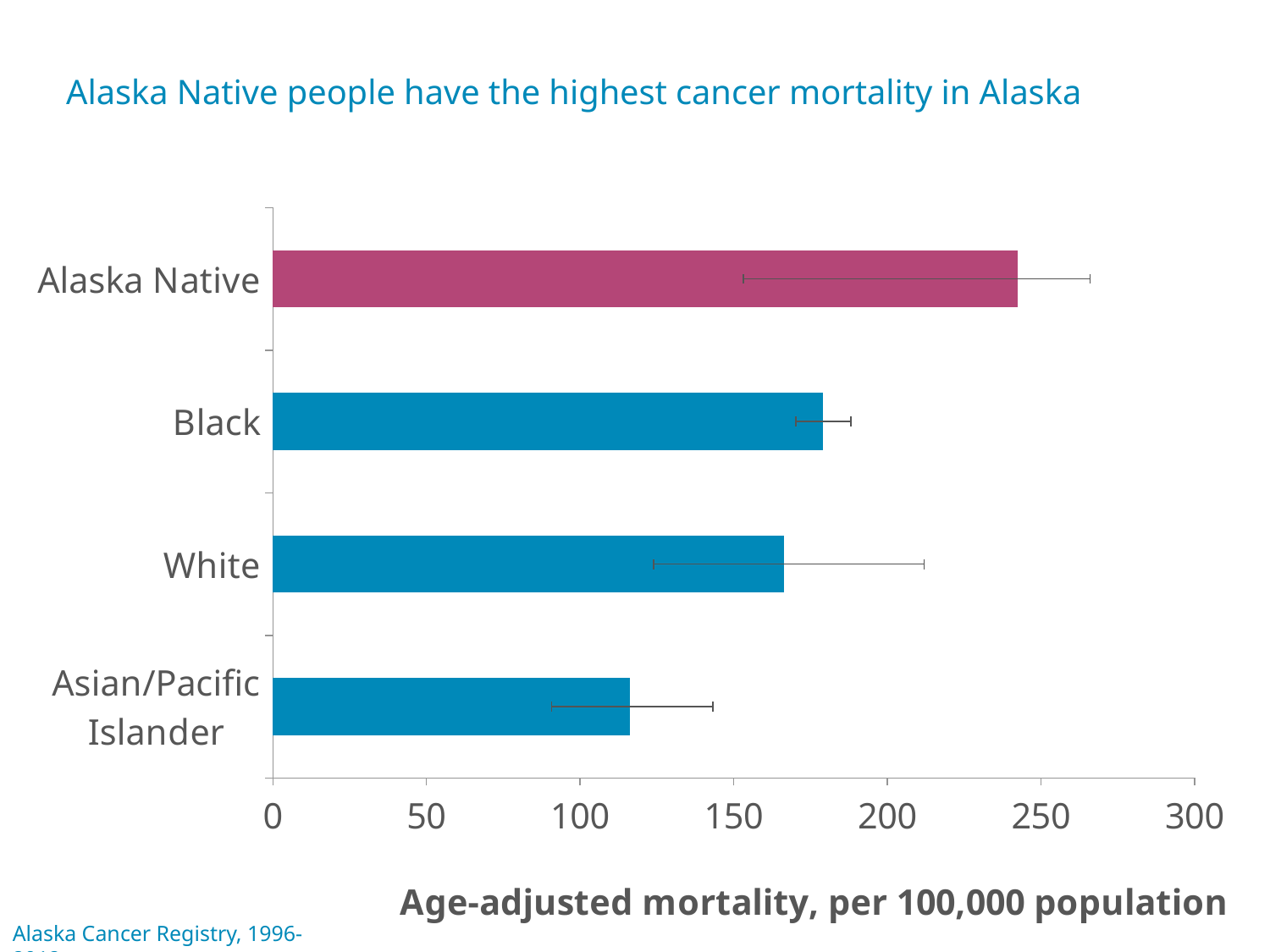
Which has the larger age-adjusted mortality, Alaska Native or Black? Alaska Native Is the value for Alaska Native greater or less than 200? greater Which category has the highest age-adjusted cancer mortality? Alaska Native How many categories are plotted in the chart? 4 What colour is the bar for Alaska Native? magenta/pink Which category has the lowest age-adjusted cancer mortality? Asian/Pacific Islander Is the value for Black greater or less than 150? greater Which has the larger age-adjusted mortality, White or Asian/Pacific Islander? White What is the label of the horizontal axis? Age-adjusted mortality, per 100,000 population What kind of chart is shown on the slide? bar chart Is the value for White greater or less than 200? less